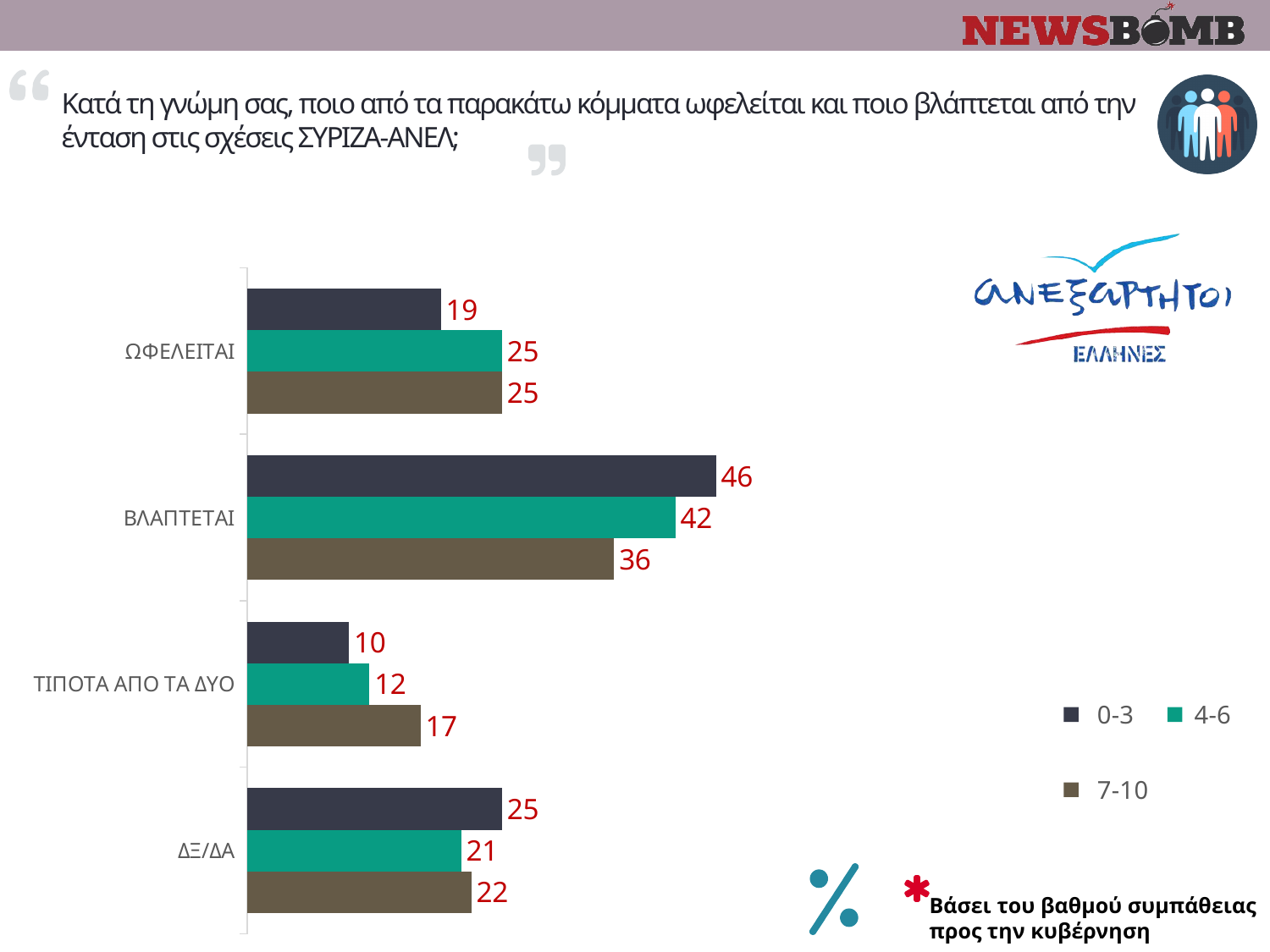
What is the value for ΤΙΠΟΤΑ ΑΠΟ ΤΑ ΔΥΟ in the 7-10 series? 17 What is the value for ΒΛΑΠΤΕΤΑΙ in the 0-3 series? 46 What is the difference between the 0-3 and 7-10 values for ΒΛΑΠΤΕΤΑΙ? 10 What is the value for ΔΞ/ΔΑ in the 4-6 series? 21 Which series is shown in green in the legend? 4-6 Which category has the lowest value in the 0-3 series? ΤΙΠΟΤΑ ΑΠΟ ΤΑ ΔΥΟ What is the difference between the 7-10 and 0-3 values for ΤΙΠΟΤΑ ΑΠΟ ΤΑ ΔΥΟ? 7 How many series does the legend list? 3 What kind of chart is shown on the slide? bar chart How many categories are shown on the chart? 4 For ΩΦΕΛΕΙΤΑΙ, which is larger: the 0-3 value or the 4-6 value? 4-6 Which category has the highest value in the 4-6 series? ΒΛΑΠΤΕΤΑΙ